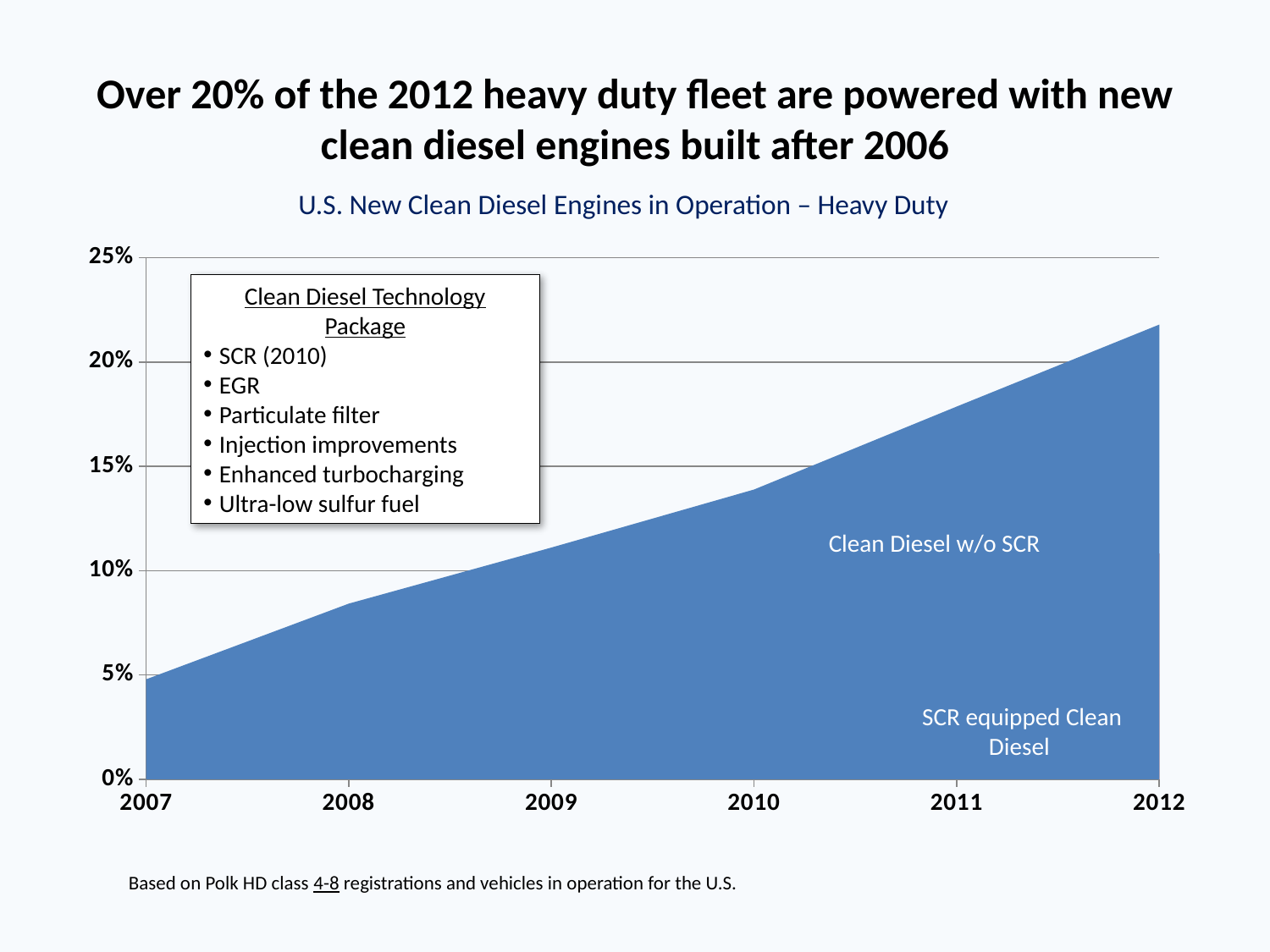
Is the value for 2007 greater or less than 10%? less What is the title of the chart? U.S. New Clean Diesel Engines in Operation – Heavy Duty Is the value for 2011 greater or less than 15%? greater Which year has the lowest share of new clean diesel engines in operation? 2007 How many years are shown on the x axis of the chart? 6 Which year has the highest share of new clean diesel engines in operation? 2012 Is the value for 2012 greater or less than 20%? greater What is the highest value shown on the y axis of the chart? 25% Do the values rise or fall from 2007 to 2012? Rise Which year has the larger value, 2009 or 2011? 2011 What kind of chart is shown on the slide? Area chart